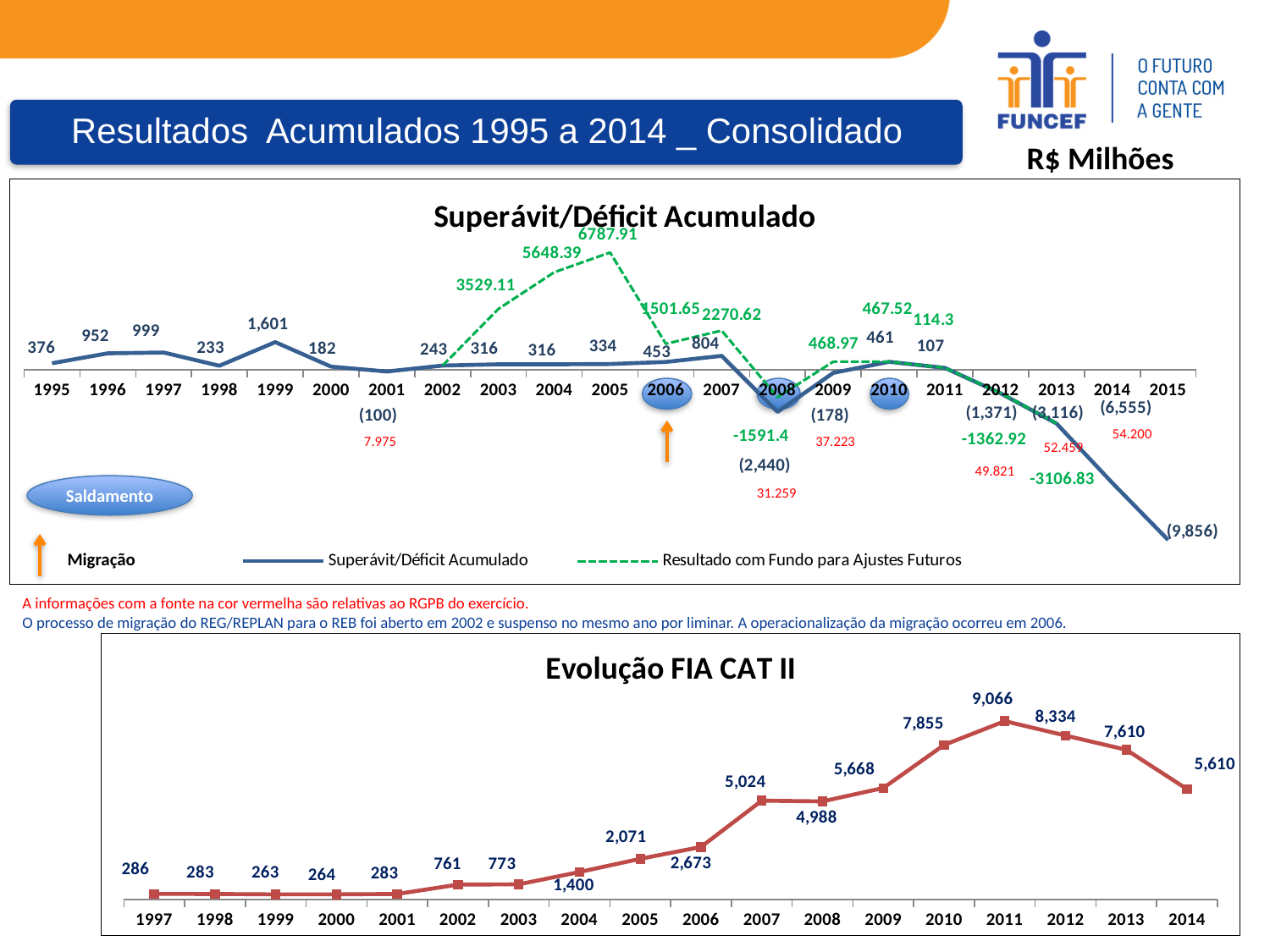
How many years are shown on the x axis of the 'Evolução FIA CAT II' chart? 18 In the 'Superávit/Déficit Acumulado' chart, what is the value of the 'Resultado com Fundo para Ajustes Futuros' series for 2005? 6787.91 In the 'Evolução FIA CAT II' chart, what is the difference between the values for 2011 and 2014? 3,456 In the 'Superávit/Déficit Acumulado' chart, does the Superávit/Déficit Acumulado series rise or fall from 2011 to 2015? Fall In the 'Evolução FIA CAT II' chart, what is the value for 2011? 9,066 How many series does the legend of the 'Superávit/Déficit Acumulado' chart list? 2 In the 'Evolução FIA CAT II' chart, which year has the lowest value? 1999 What kind of chart is 'Evolução FIA CAT II'? Line chart In the 'Superávit/Déficit Acumulado' chart, what is the value of the Superávit/Déficit Acumulado series for 2015? (9,856) In the 'Evolução FIA CAT II' chart, which is larger, the value for 2007 or the value for 2008? 2007 In the 'Evolução FIA CAT II' chart, which year has the highest value? 2011 In the 'Superávit/Déficit Acumulado' chart, what is the value of the Superávit/Déficit Acumulado series for 1999? 1,601